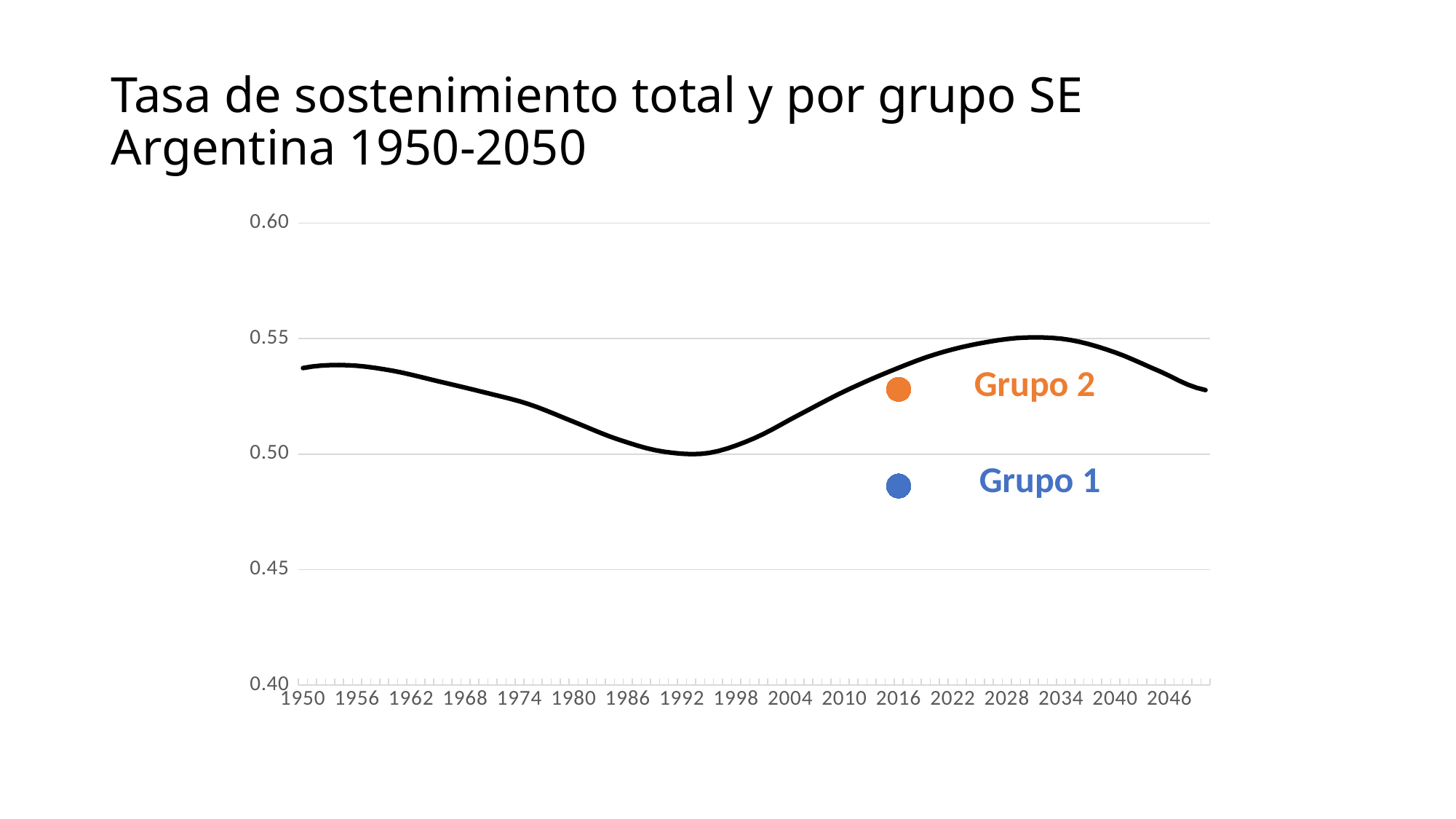
Is the value of the black line in 1992 greater or less than 0.55? less At 2016, which dot is higher, Grupo 1 or Grupo 2? Grupo 2 Does the black line rise or fall between 1992 and 2030? rise Is the value of the black line in 1950 greater or less than 0.50? greater Is the value of the Grupo 2 dot greater or less than 0.50? greater Which group is marked with the orange dot? Grupo 2 Which is higher on the black line, the value in 1950 or the value in 1992? 1950 Does the black line rise or fall between 1950 and 1992? fall What kind of chart is shown on the slide? line chart What is the title of the chart on the slide? Tasa de sostenimiento total y por grupo SE Argentina 1950-2050